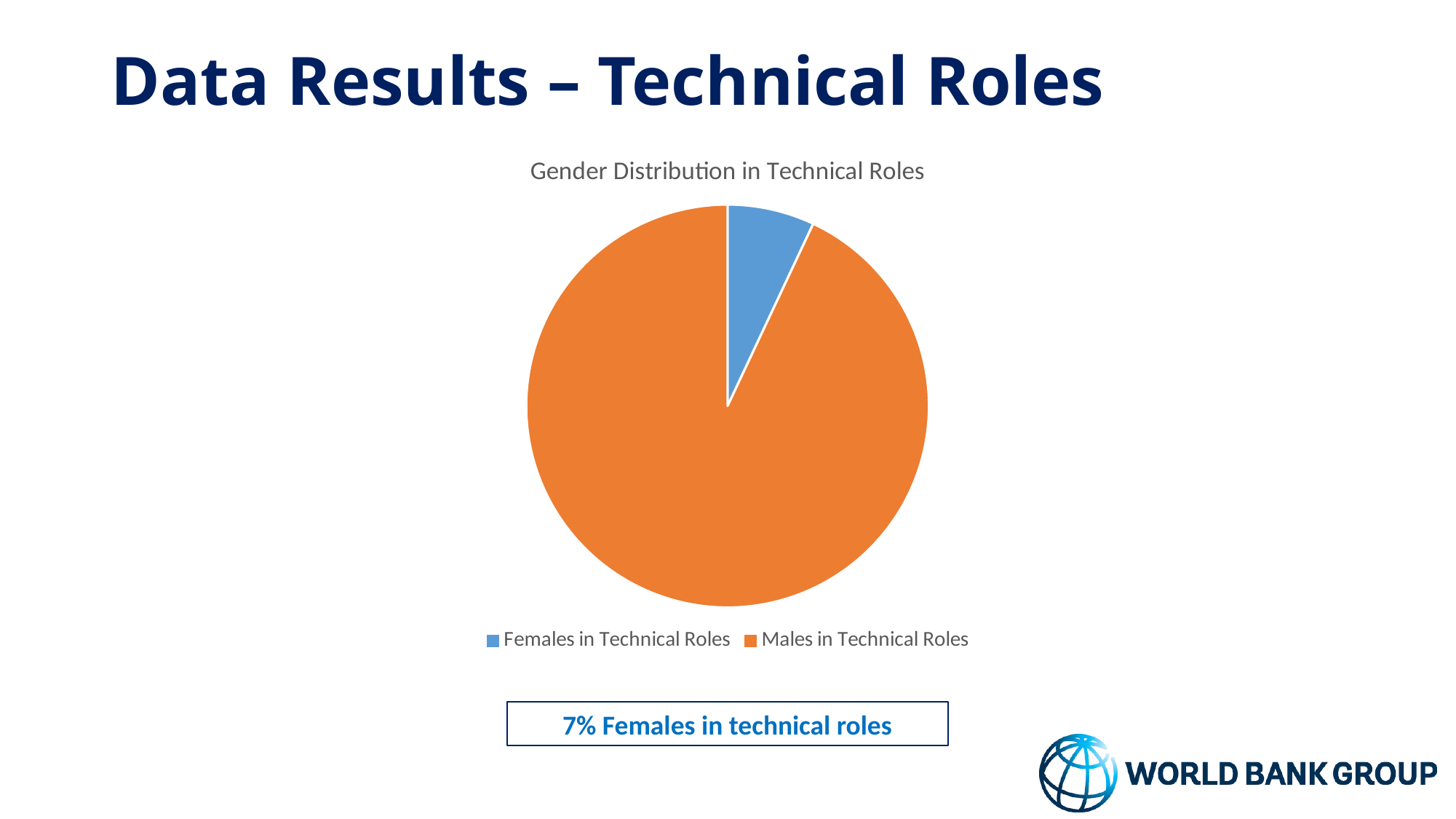
How many slices does the pie chart have? 2 What kind of chart is shown on the slide? Pie chart According to the slide, what share of technical roles is held by females? 7% Which category has the largest slice of the pie? Males in Technical Roles Which category has the smallest slice of the pie? Females in Technical Roles What is the title of the chart? Gender Distribution in Technical Roles How many entries does the legend list? 2 What colour represents Females in Technical Roles in the pie chart? Blue Which slice is larger, Females in Technical Roles or Males in Technical Roles? Males in Technical Roles